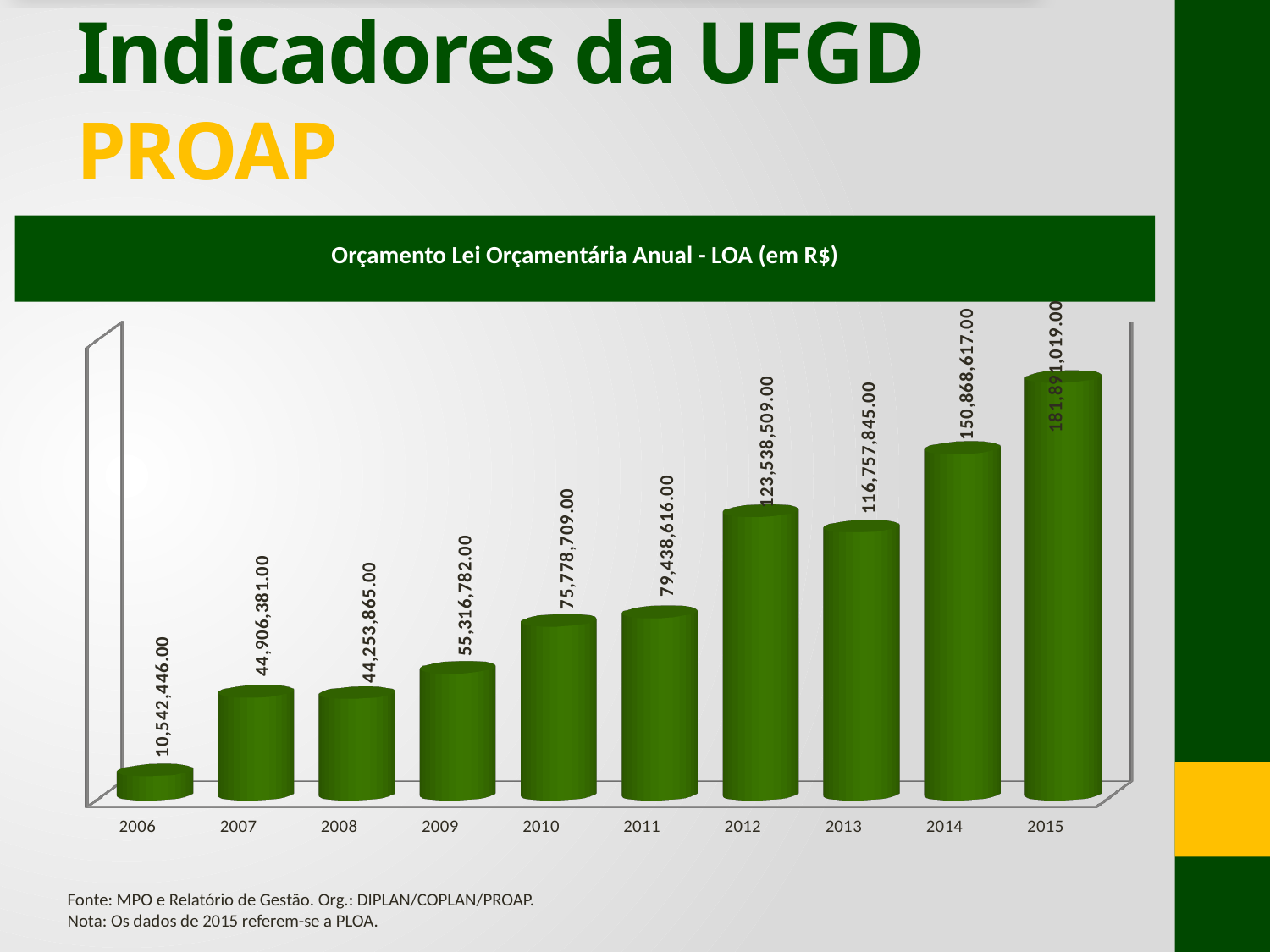
Which year has the highest value in the chart 'Orçamento Lei Orçamentária Anual - LOA (em R$)'? 2015 Do the values in the chart 'Orçamento Lei Orçamentária Anual - LOA (em R$)' generally rise or fall from 2006 to 2015? Rise What is the value for 2006 in the chart 'Orçamento Lei Orçamentária Anual - LOA (em R$)'? 10,542,446.00 What kind of chart is 'Orçamento Lei Orçamentária Anual - LOA (em R$)'? Bar chart Which year has the lowest value in the chart 'Orçamento Lei Orçamentária Anual - LOA (em R$)'? 2006 How many years are shown in the chart 'Orçamento Lei Orçamentária Anual - LOA (em R$)'? 10 What is the difference between the values for 2012 and 2013 in the chart 'Orçamento Lei Orçamentária Anual - LOA (em R$)'? 6,780,664.00 What is the value for 2014 in the chart 'Orçamento Lei Orçamentária Anual - LOA (em R$)'? 150,868,617.00 What is the difference between the values for 2011 and 2010 in the chart 'Orçamento Lei Orçamentária Anual - LOA (em R$)'? 3,659,907.00 What is the value for 2010 in the chart 'Orçamento Lei Orçamentária Anual - LOA (em R$)'? 75,778,709.00 Which year has the larger value in the chart 'Orçamento Lei Orçamentária Anual - LOA (em R$)', 2012 or 2013? 2012 What is the value for 2013 in the chart 'Orçamento Lei Orçamentária Anual - LOA (em R$)'? 116,757,845.00